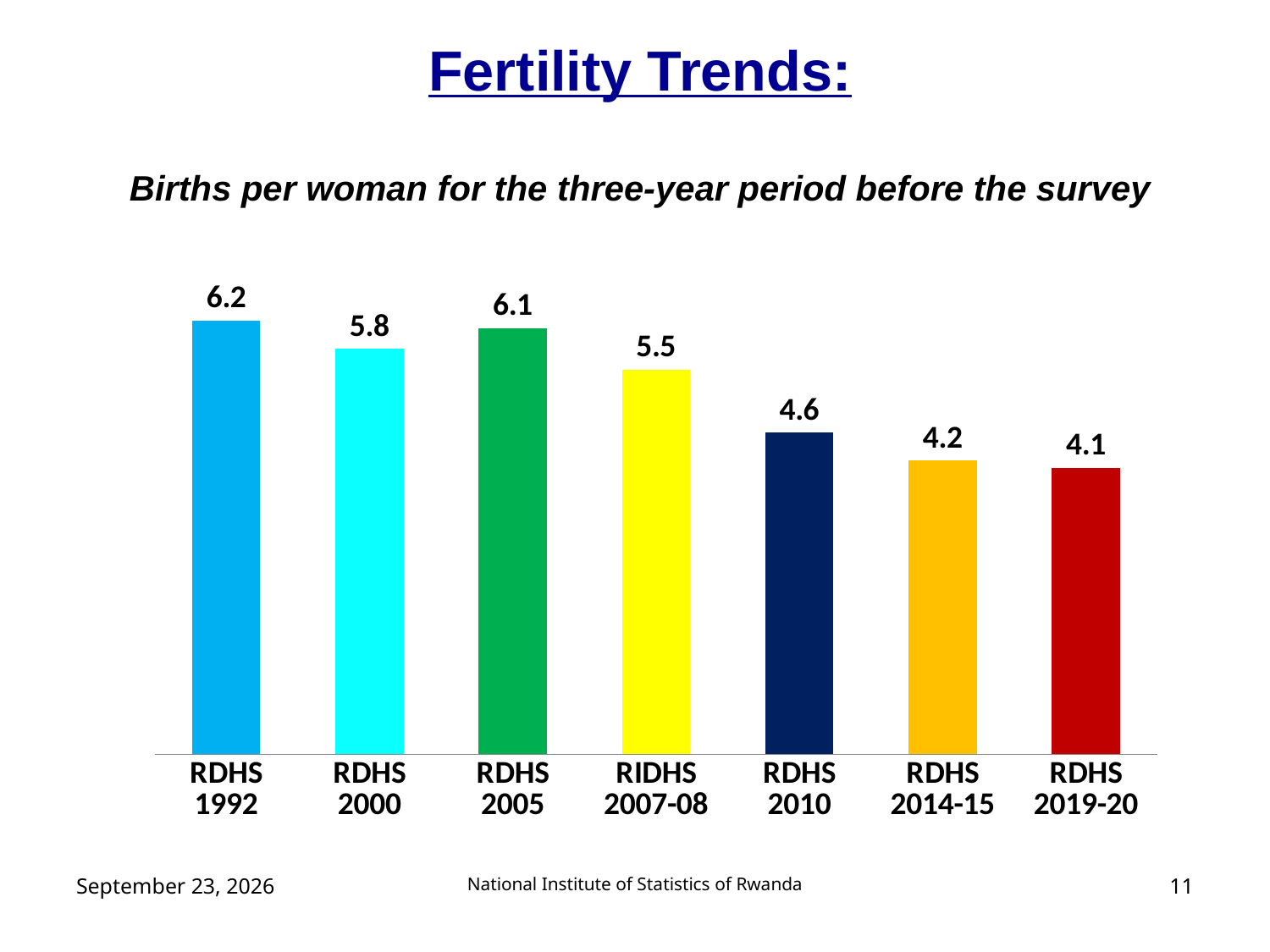
Which is larger, the value for RDHS 2000 or RDHS 2005? RDHS 2005 How many surveys are shown on the chart? 7 What is the difference between the values for RDHS 1992 and RDHS 2019-20? 2.1 Which survey has the lowest births per woman? RDHS 2019-20 What is the value for RIDHS 2007-08? 5.5 What is the value for RDHS 1992? 6.2 What is the value for RDHS 2019-20? 4.1 Do the values generally rise or fall from RDHS 1992 to RDHS 2019-20? Fall Which survey has the highest births per woman? RDHS 1992 What is the value for RDHS 2010? 4.6 What is the difference between the values for RDHS 2005 and RDHS 2010? 1.5 What kind of chart is shown on the slide? Bar chart